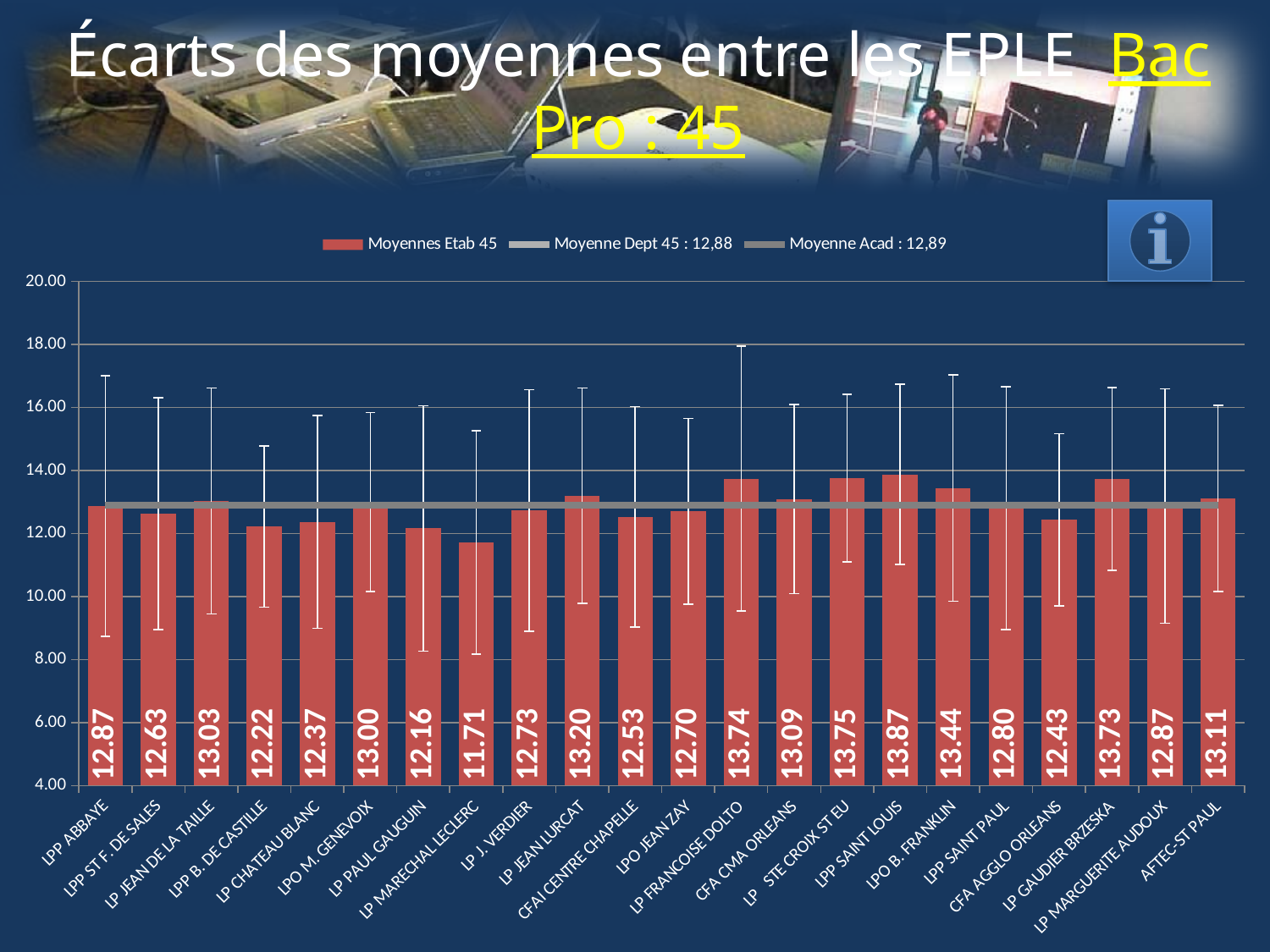
How many series does the legend list? 3 What is the value for LP MARECHAL LECLERC? 11.71 What value does the legend give for Moyenne Acad? 12,89 What is the difference between the values for LPP SAINT LOUIS and LP MARECHAL LECLERC? 2.16 Which is larger, the value for LP JEAN LURCAT or the value for LPP B. DE CASTILLE? LP JEAN LURCAT What is the value for LPP SAINT LOUIS? 13.87 What value does the legend give for Moyenne Dept 45? 12,88 What is the value for CFA CMA ORLEANS? 13.09 Which establishment has the lowest value? LP MARECHAL LECLERC What kind of chart is this? bar chart How many establishments are shown on the x axis? 22 Which establishment has the highest value? LPP SAINT LOUIS